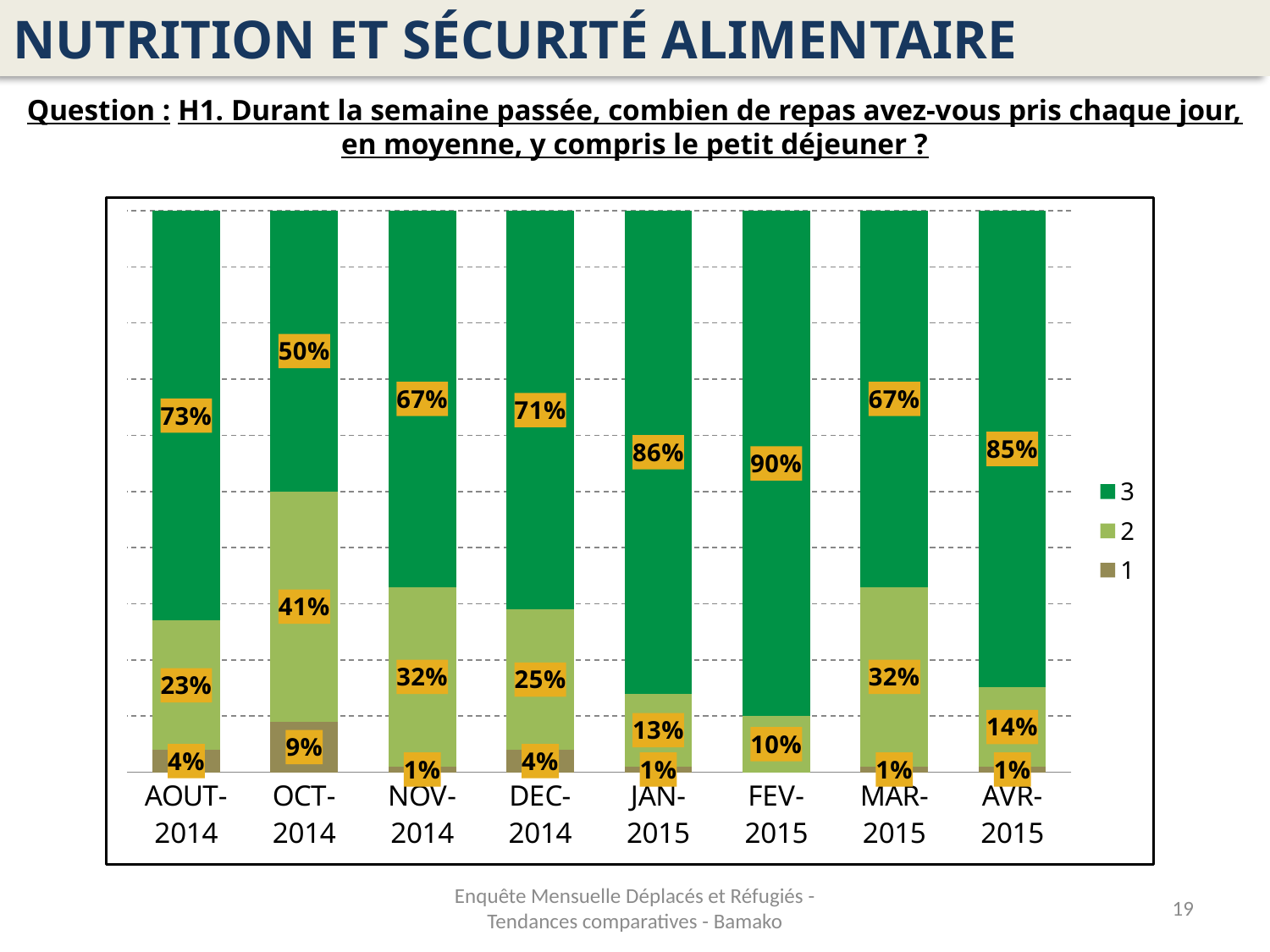
How many series does the legend list? 3 Which month has the highest value for the '3' series? FEV-2015 Which month has the lowest value for the '3' series? OCT-2014 What is the difference between the '3' series values for FEV-2015 and JAN-2015? 4 percentage points What is the value for the '2' series in NOV-2014? 32% Which month has the highest value for the '2' series? OCT-2014 Which is larger, the '2' series value for DEC-2014 or for MAR-2015? MAR-2015 What is the value for the '1' series in OCT-2014? 9% How many months are shown on the x axis? 8 What is the total of the stacked bar for OCT-2014? 100% What percentage of respondents reported 3 meals per day in OCT-2014? 50% What kind of chart is shown on the slide? Stacked bar chart